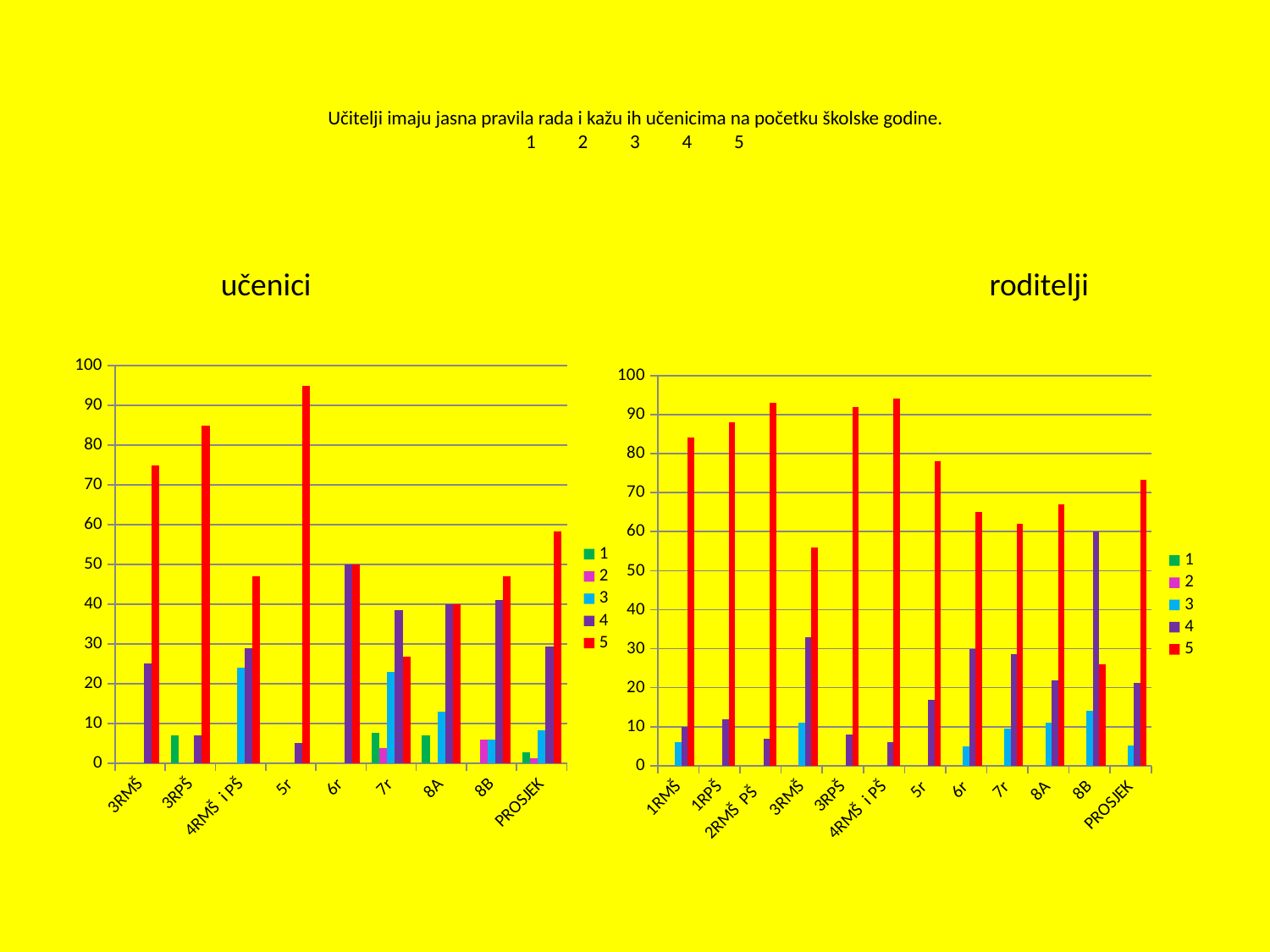
In the "roditelji" chart, which is larger for series 5: 6r or 3RMŠ? 6r In the "učenici" chart, is the value of series 5 for PROSJEK greater or less than 50? greater In the "roditelji" chart, is the value of series 5 for 5r greater or less than 70? greater What kind of chart is the "učenici" chart on the left? bar chart In the "učenici" chart, which category has the lowest value for series 5? 7r In the "učenici" chart, which category has the highest value for series 5? 5r In the "roditelji" chart, which category has the lowest value for series 5? 8B How many categories are shown on the x axis of the "roditelji" chart? 12 In the "učenici" chart, is the value of series 5 for 3RMŠ greater or less than 70? greater How many series does the legend of the "roditelji" chart list? 5 How many categories are shown on the x axis of the "učenici" chart? 9 In the "učenici" chart, which is larger for series 5: 3RPŠ or 3RMŠ? 3RPŠ